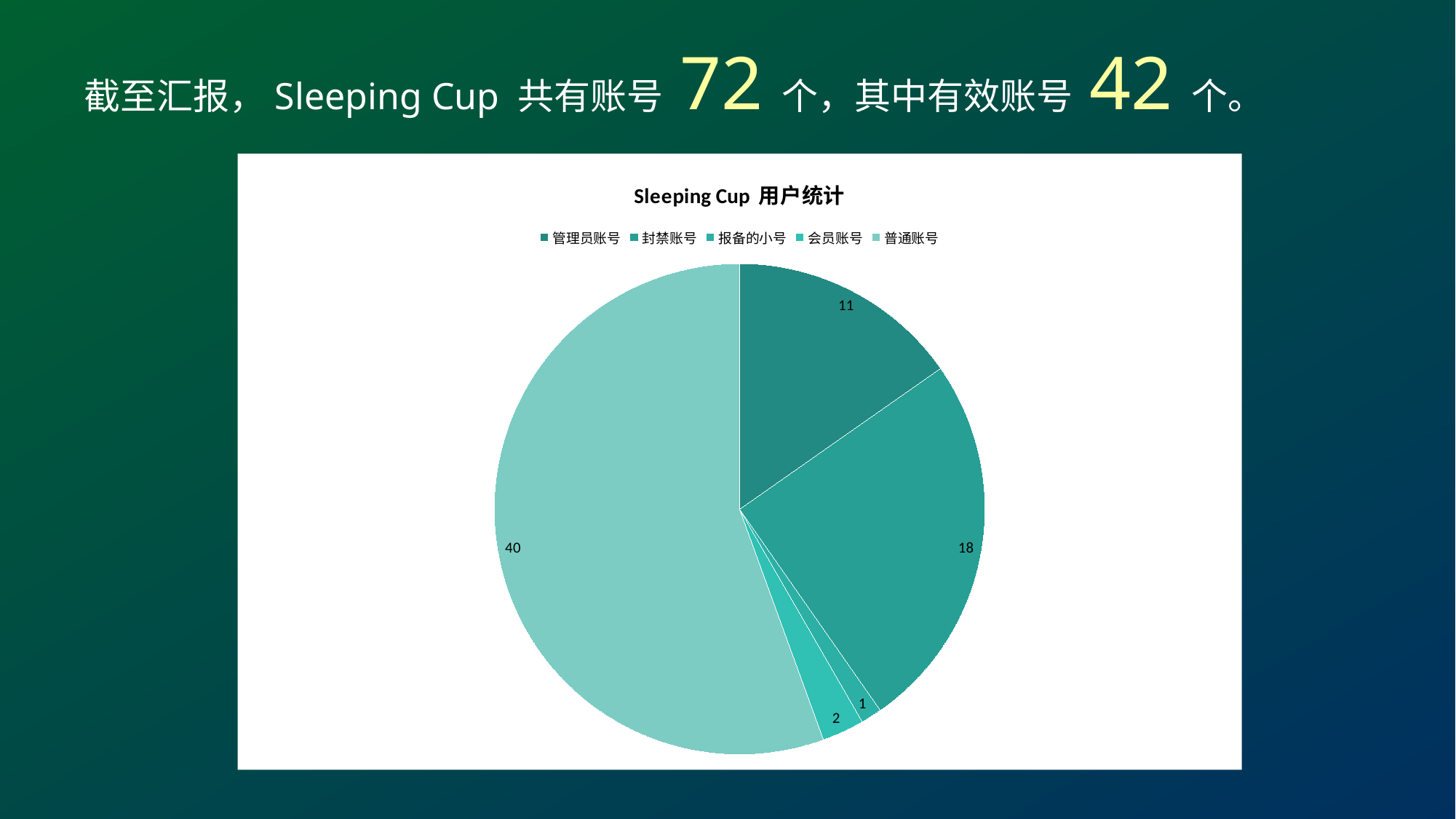
Which is larger, the value for 管理员账号 or the value for 封禁账号? 封禁账号 What is the value for 普通账号 in the pie chart? 40 What is the value for 报备的小号 in the pie chart? 1 What share of the pie does 封禁账号 represent? 25% What kind of chart is shown on the slide? pie chart What is the value for 管理员账号 in the pie chart? 11 Which category has the largest slice in the pie chart? 普通账号 Which category has the smallest slice in the pie chart? 报备的小号 What is the value for 会员账号 in the pie chart? 2 How many categories does the legend of the pie chart list? 5 What is the value for 封禁账号 in the pie chart? 18 What is the difference between the values for 普通账号 and 封禁账号? 22